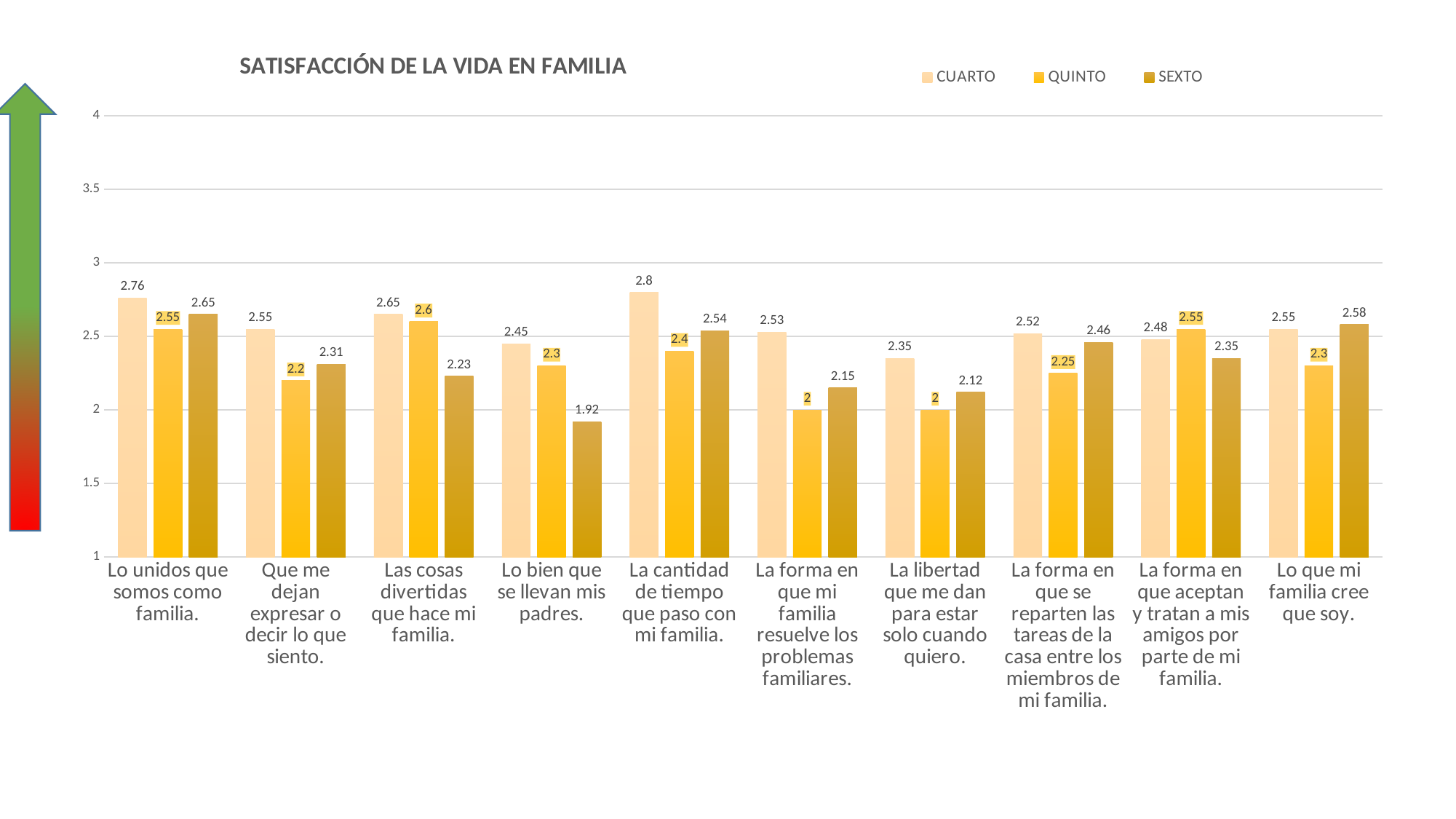
Which category has the highest CUARTO value? La cantidad de tiempo que paso con mi familia. How many categories are shown on the x axis? 10 What type of chart is shown on the slide? bar chart Which category has the lowest SEXTO value? Lo bien que se llevan mis padres. How many series does the legend list? 3 What is the QUINTO value for 'La forma en que se reparten las tareas de la casa entre los miembros de mi familia.'? 2.25 What is the CUARTO value for 'La cantidad de tiempo que paso con mi familia.'? 2.8 Is the SEXTO value for 'Lo bien que se llevan mis padres.' greater or less than 2? less What is the title of the chart? SATISFACCIÓN DE LA VIDA EN FAMILIA What is the SEXTO value for 'Lo bien que se llevan mis padres.'? 1.92 For 'Lo que mi familia cree que soy.', which is larger, the CUARTO value or the SEXTO value? SEXTO What is the difference between the CUARTO and QUINTO values for 'La forma en que mi familia resuelve los problemas familiares.'? 0.53